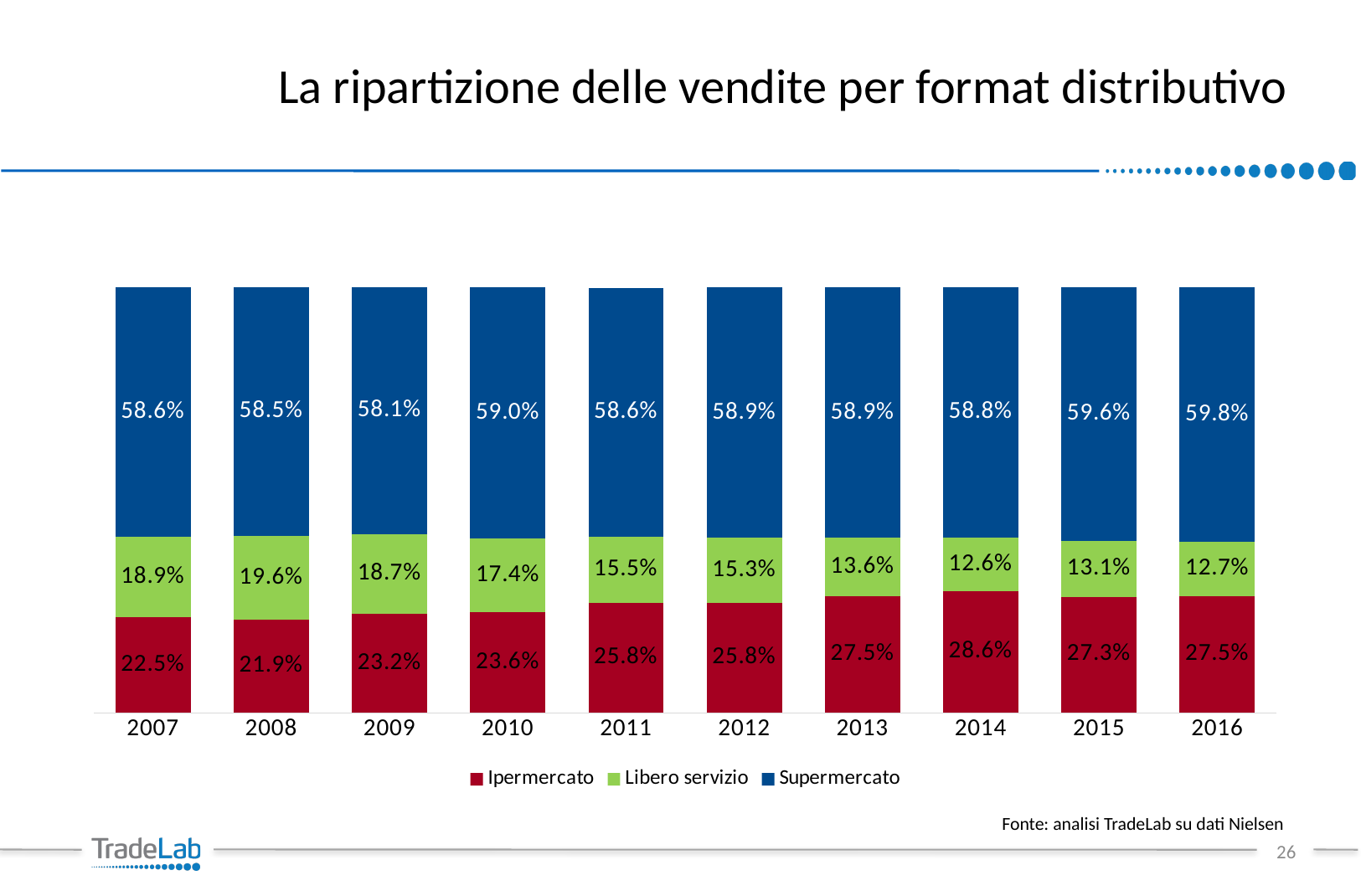
What is the Libero servizio share in 2008? 19.6% What kind of chart is shown on the slide? Stacked bar chart In which year is the Supermercato share lowest? 2009 In which year is the Libero servizio share lowest? 2014 By how many percentage points did the Ipermercato share change from 2007 to 2016? 5.0 percentage points How many years are shown on the x axis? 10 What is the Ipermercato value for 2014? 28.6% How many series does the legend list? 3 Does the Libero servizio share generally rise or fall from 2007 to 2016? Fall In which year is the Ipermercato share highest? 2014 What share does Supermercato have in 2010? 59.0% Which year has the larger Libero servizio share, 2013 or 2015? 2013